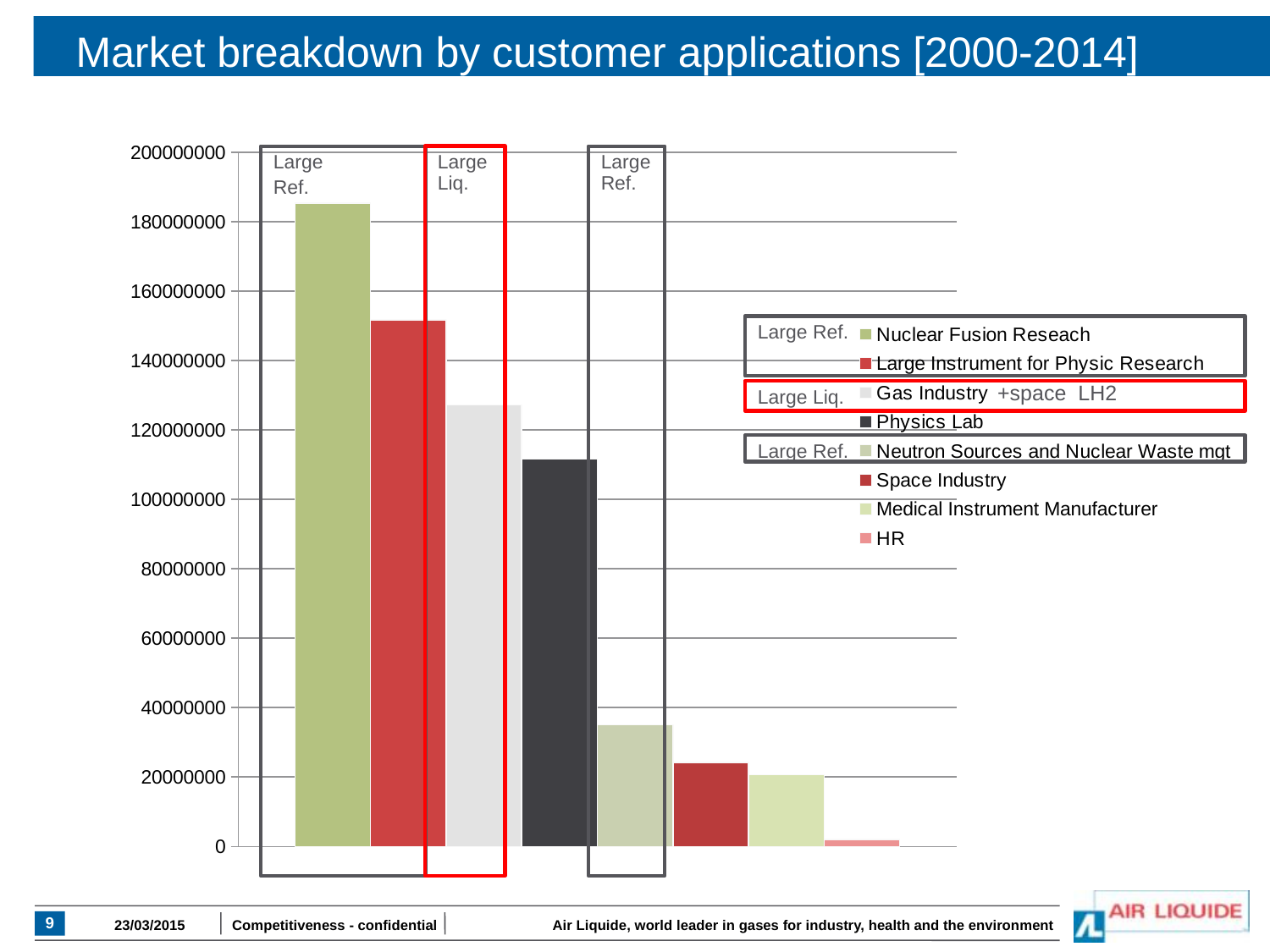
Is the value for Physics Lab greater or less than 100000000? greater Which series has the highest value? Nuclear Fusion Reseach Do the bar values rise or fall from left to right across the chart? fall What kind of chart is shown on the slide? bar chart How many series does the legend list? 8 What is the title of the slide? Market breakdown by customer applications [2000-2014] Is the value for Neutron Sources and Nuclear Waste mgt greater or less than 40000000? less Which is larger, the value for Physics Lab or the value for Space Industry? Physics Lab Which series has the lowest value? HR Is the value for Nuclear Fusion Reseach greater or less than 180000000? greater